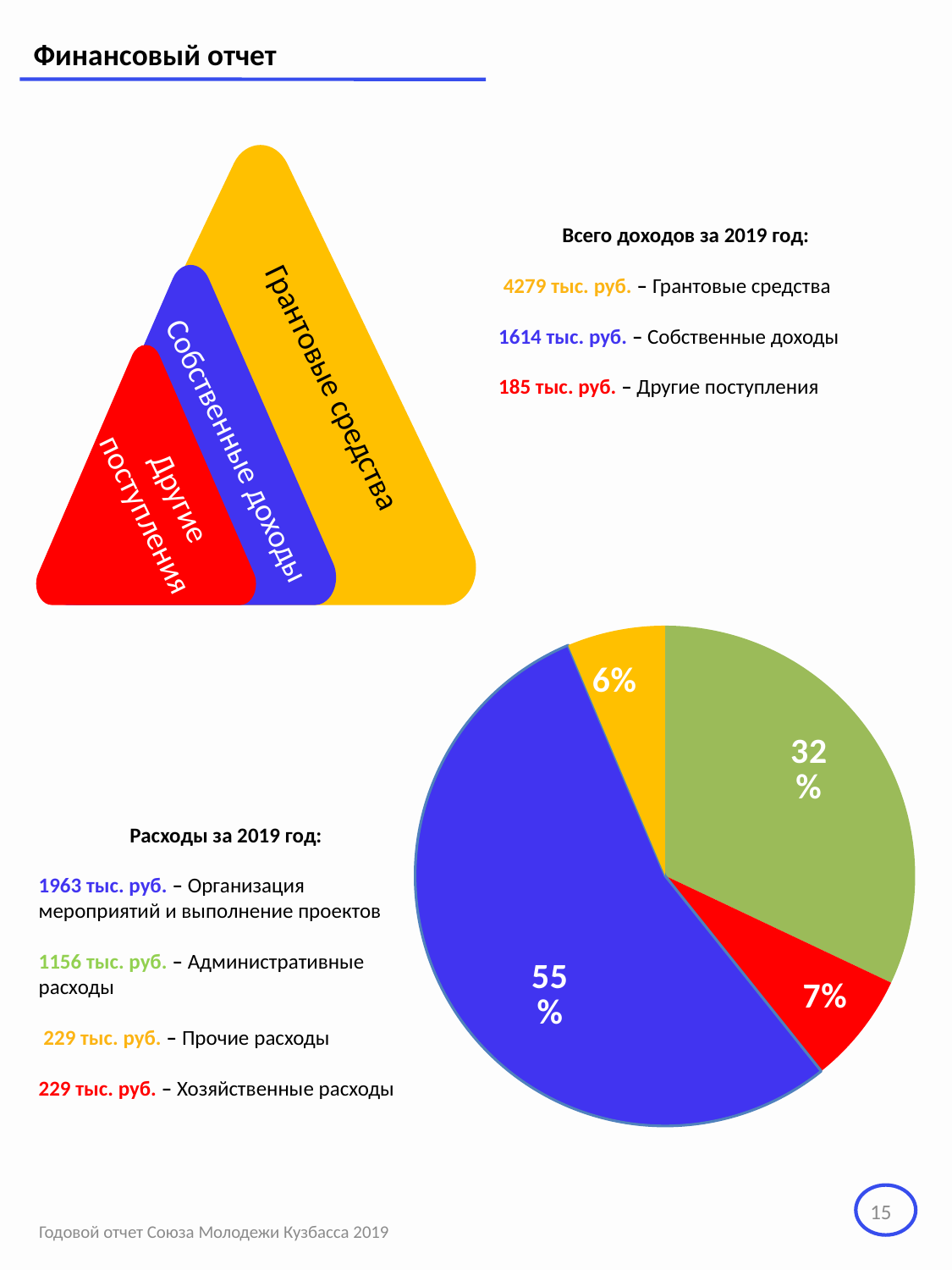
In the pie chart, what share is shown on the green slice? 32% In the pie chart, what share is shown on the red slice? 7% According to the expenses list next to the pie chart, what amount is given for Организация мероприятий и выполнение проектов? 1963 тыс. руб. Which slice of the pie chart is the smallest? the yellow slice (6%) In the pie chart, what share is shown on the blue slice? 55% In the pie chart, which is larger: the green slice or the red slice? the green slice What is the difference in percentage points between the blue slice and the green slice of the pie chart? 23 According to the expenses list next to the pie chart, what amount is given for Административные расходы? 1156 тыс. руб. How many slices does the pie chart have? 4 Which slice of the pie chart is the largest? the blue slice (55%) What kind of chart is shown in the lower right of the slide? pie chart